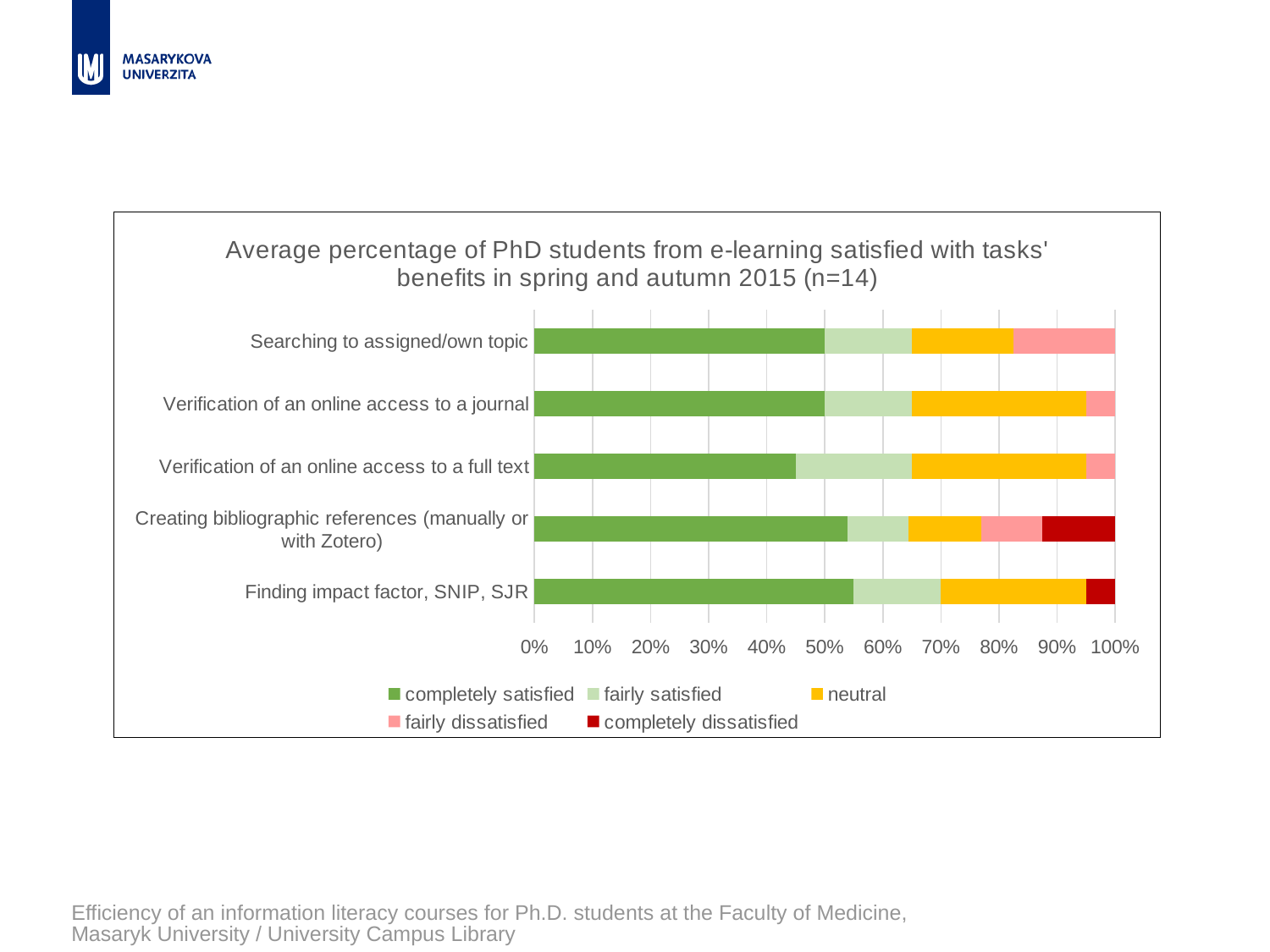
Which legend entry is shown in dark red? completely dissatisfied Which task has the lowest 'completely satisfied' share? Verification of an online access to a full text Which task has the largest 'completely dissatisfied' share? Creating bibliographic references (manually or with Zotero) What is the sample size (n) stated in the chart title? 14 What is the 'completely satisfied' share for 'Searching to assigned/own topic'? 50% What is the 'completely satisfied' share for 'Verification of an online access to a journal'? 50% Is the 'completely satisfied' share for 'Finding impact factor, SNIP, SJR' greater or less than 50%? greater How many task categories are plotted on the chart? 5 How many series does the legend list? 5 Is the 'completely satisfied' share for 'Verification of an online access to a full text' greater or less than 50%? less What kind of chart is shown on the slide? bar chart Which is larger: the 'completely satisfied' share for 'Finding impact factor, SNIP, SJR' or for 'Verification of an online access to a full text'? Finding impact factor, SNIP, SJR